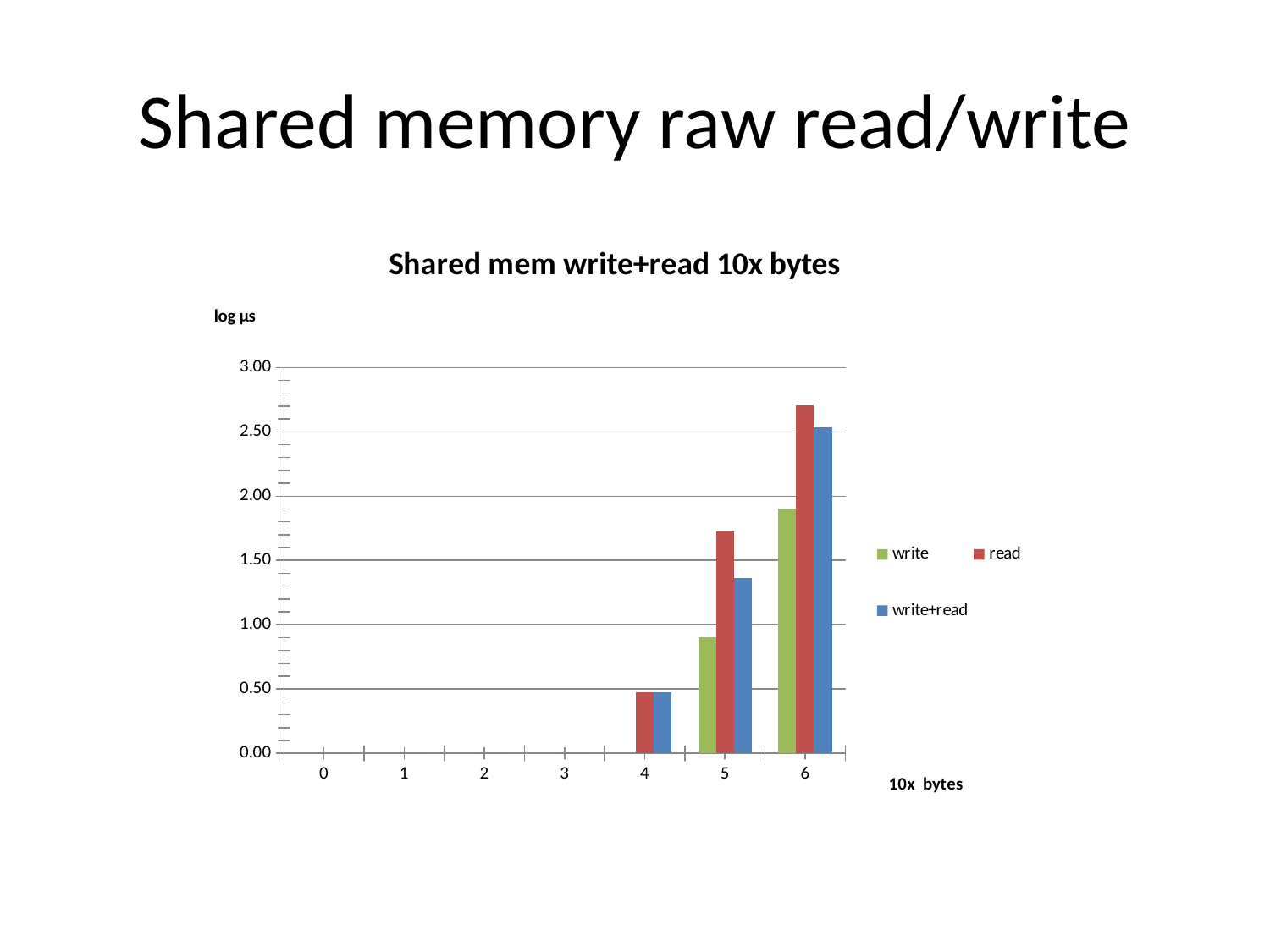
What is the label of the y axis? log µs Is the value for read at category 5 greater or less than 1.50? greater Do the values for the read series rise or fall from category 4 to category 6? rise How many categories are shown on the x axis? 7 What kind of chart is shown on the slide? bar chart Is the value for write at category 6 greater or less than 2.00? less Is the value for write+read at category 5 greater or less than 1.00? greater Which category has the highest value for the read series? 6 What is the title of the chart? Shared mem write+read 10x bytes At category 6, which is larger, read or write? read How many series does the legend list? 3